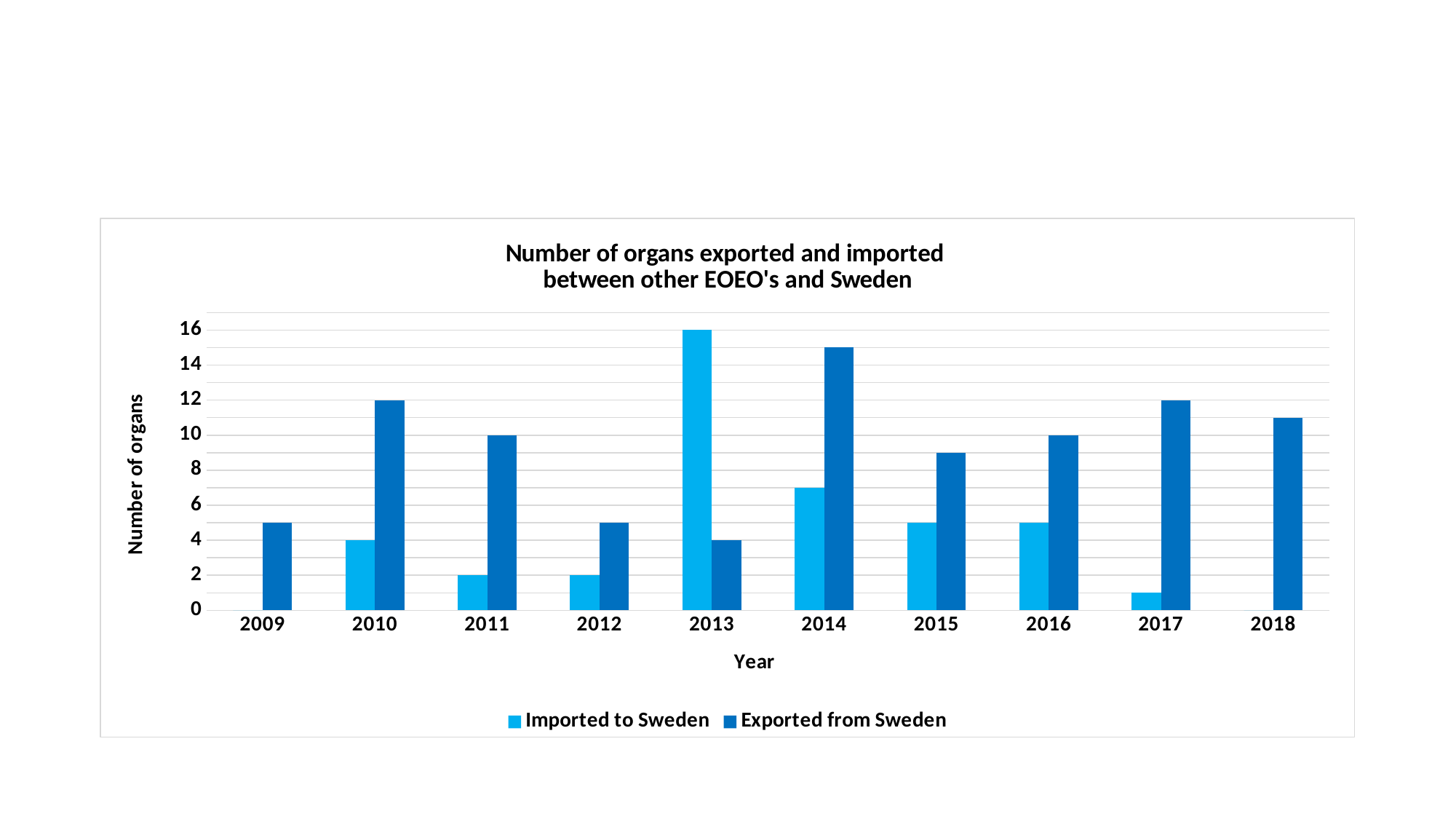
How many series does the legend list? 2 How many years are shown on the x axis? 10 What is the value for Exported from Sweden in 2010? 12 Which year has the highest value for Exported from Sweden? 2014 Is the value for Exported from Sweden in 2014 greater or less than 14? greater What is the value for Exported from Sweden in 2011? 10 What is the difference between Exported from Sweden in 2017 and Exported from Sweden in 2016? 2 What is the value for Imported to Sweden in 2013? 16 Which is larger in 2013, Imported to Sweden or Exported from Sweden? Imported to Sweden What type of chart is shown on the slide? bar chart What is the value for Imported to Sweden in 2012? 2 Which year has the highest value for Imported to Sweden? 2013